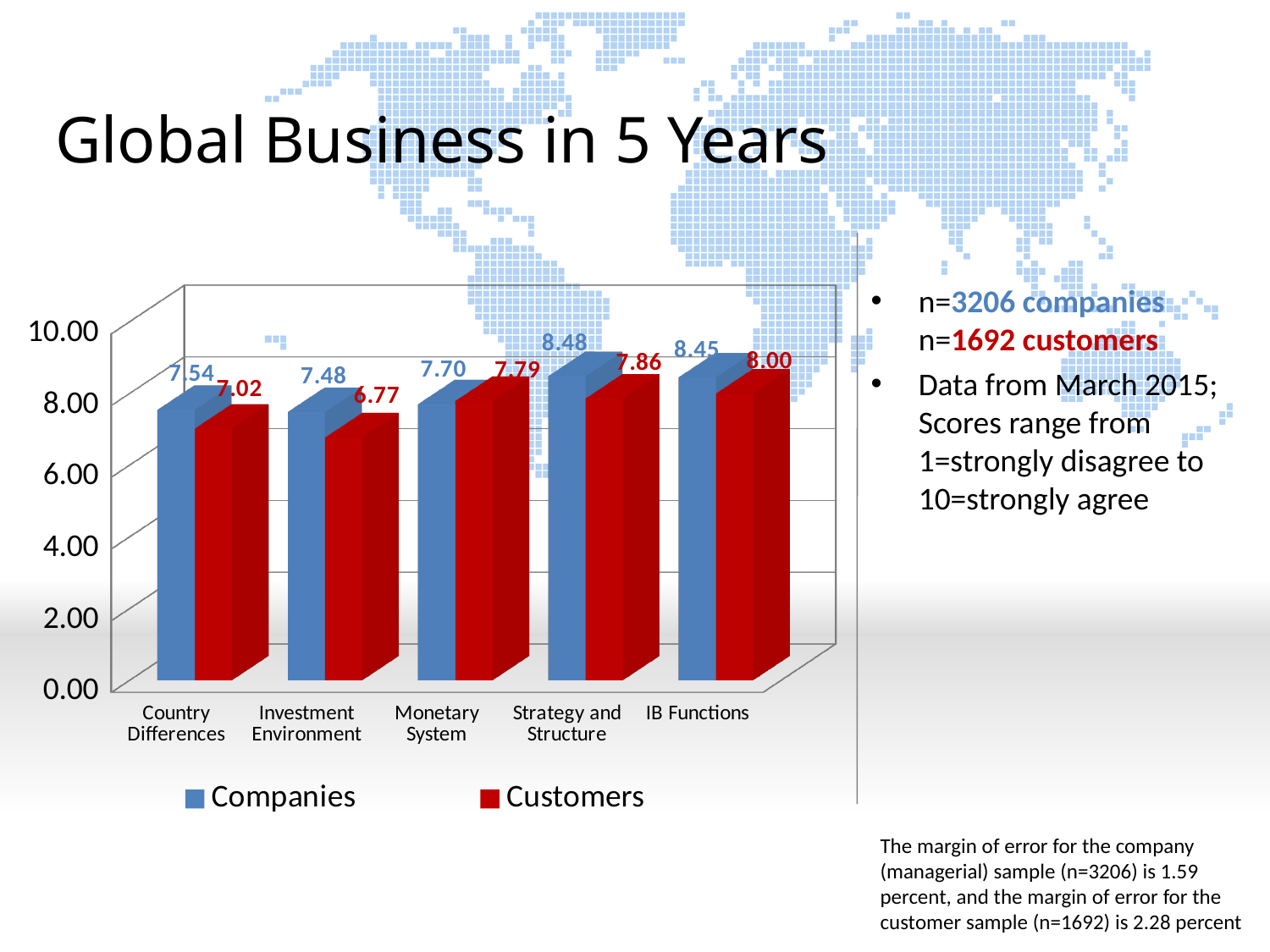
How many series does the legend list? 2 What is the difference between the Companies and Customers values for Investment Environment? 0.71 What is the Customers value for IB Functions? 8.00 What kind of chart is shown on the slide? Bar chart How many categories are shown on the x axis? 5 What is the Customers value for Investment Environment? 6.77 What is the Companies value for Monetary System? 7.70 What is the Companies value for Country Differences? 7.54 Which colour represents the Customers series? Red For Monetary System, which series has the larger value, Companies or Customers? Customers Which category has the highest Companies value? Strategy and Structure Which category has the lowest Customers value? Investment Environment